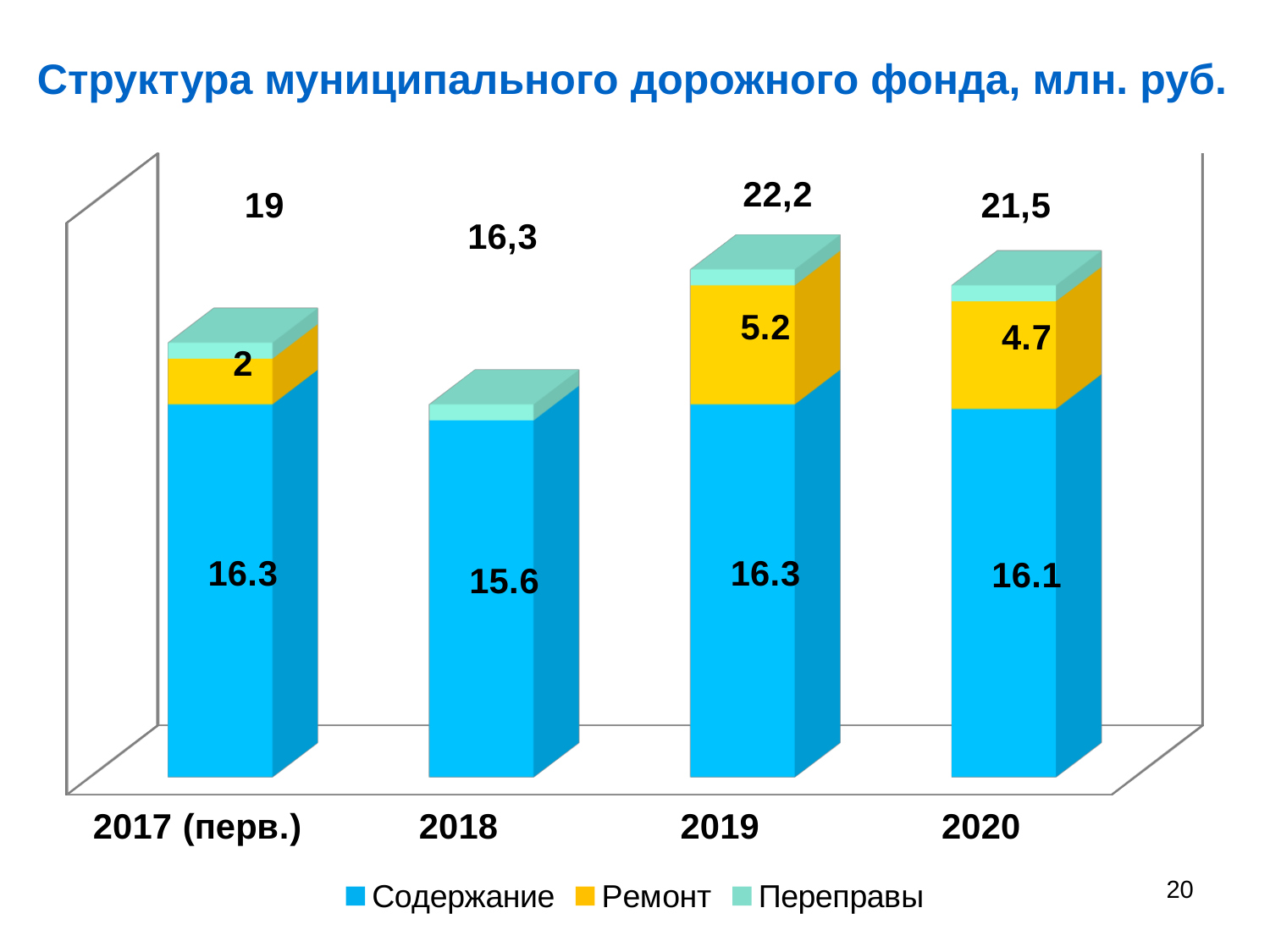
What is the value of Содержание for 2018? 15.6 How many series does the legend list? 3 How many categories (years) are shown on the x axis? 4 What is the value of Ремонт for 2017 (перв.)? 2 Which is larger: Содержание for 2018 or Содержание for 2019? 2019 What is the total value printed above the bar for 2020? 21,5 What is the difference between the Ремонт values for 2019 and 2020? 0.5 What is the title of the chart? Структура муниципального дорожного фонда, млн. руб. What is the value of Ремонт for 2019? 5.2 What kind of chart is shown on the slide? bar chart Which year has the lowest total value? 2018 Which year has the highest total value? 2019